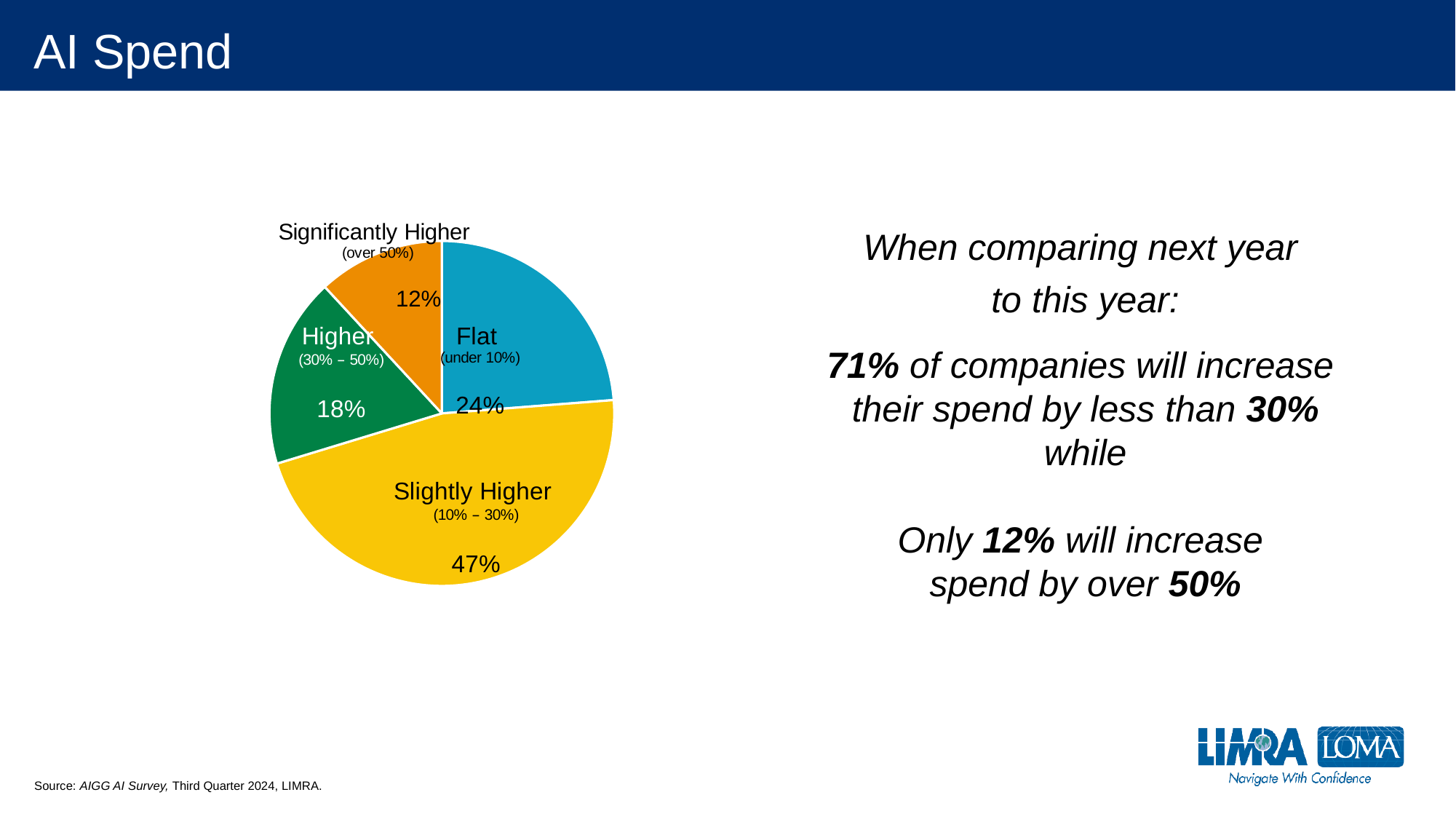
What percentage of companies expect their AI spend to be Flat (under 10%)? 24% What kind of chart is shown on the slide? Pie chart Which category has the smallest share of the pie? Significantly Higher What percentage of companies expect their AI spend to be Significantly Higher (over 50%)? 12% How many slices does the pie chart have? 4 What percentage of companies expect their AI spend to be Higher (30% – 50%)? 18% What is the combined share of the Flat and Slightly Higher slices? 71% What is the difference in percentage points between the Slightly Higher and Flat slices? 23 What colour is the Slightly Higher slice? Yellow What percentage of companies expect their AI spend to be Slightly Higher (10% – 30%)? 47% Which is larger, the Higher slice or the Significantly Higher slice? Higher Which category has the largest share of the pie? Slightly Higher